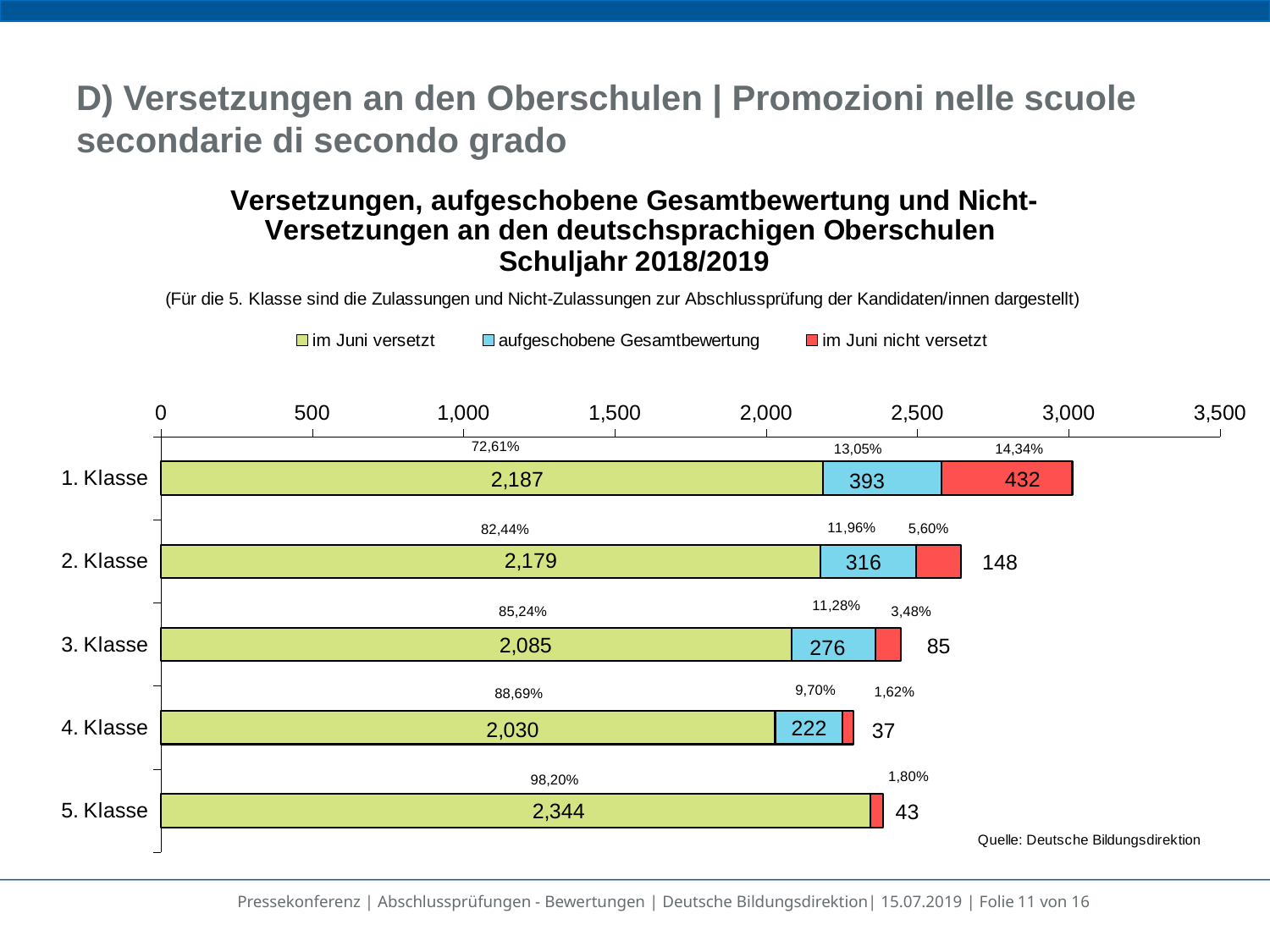
How many series does the legend list? 3 How many Klasse categories are shown on the chart? 5 What kind of chart is shown on the slide? Stacked bar chart Which Klasse has the highest value for 'im Juni versetzt'? 5. Klasse Which is larger: 'aufgeschobene Gesamtbewertung' in 1. Klasse or in 4. Klasse? 1. Klasse How many students were 'im Juni versetzt' in 1. Klasse? 2,187 What is the difference between the 'im Juni nicht versetzt' values for 1. Klasse and 2. Klasse? 284 What is the value for 'aufgeschobene Gesamtbewertung' in 3. Klasse? 276 What is the total of the stacked bar for 3. Klasse? 2,446 Is the total length of the 2. Klasse bar greater or less than 2,500? greater What percentage label is shown for 'im Juni nicht versetzt' in 2. Klasse? 5,60% Which Klasse has the lowest value for 'im Juni nicht versetzt'? 4. Klasse